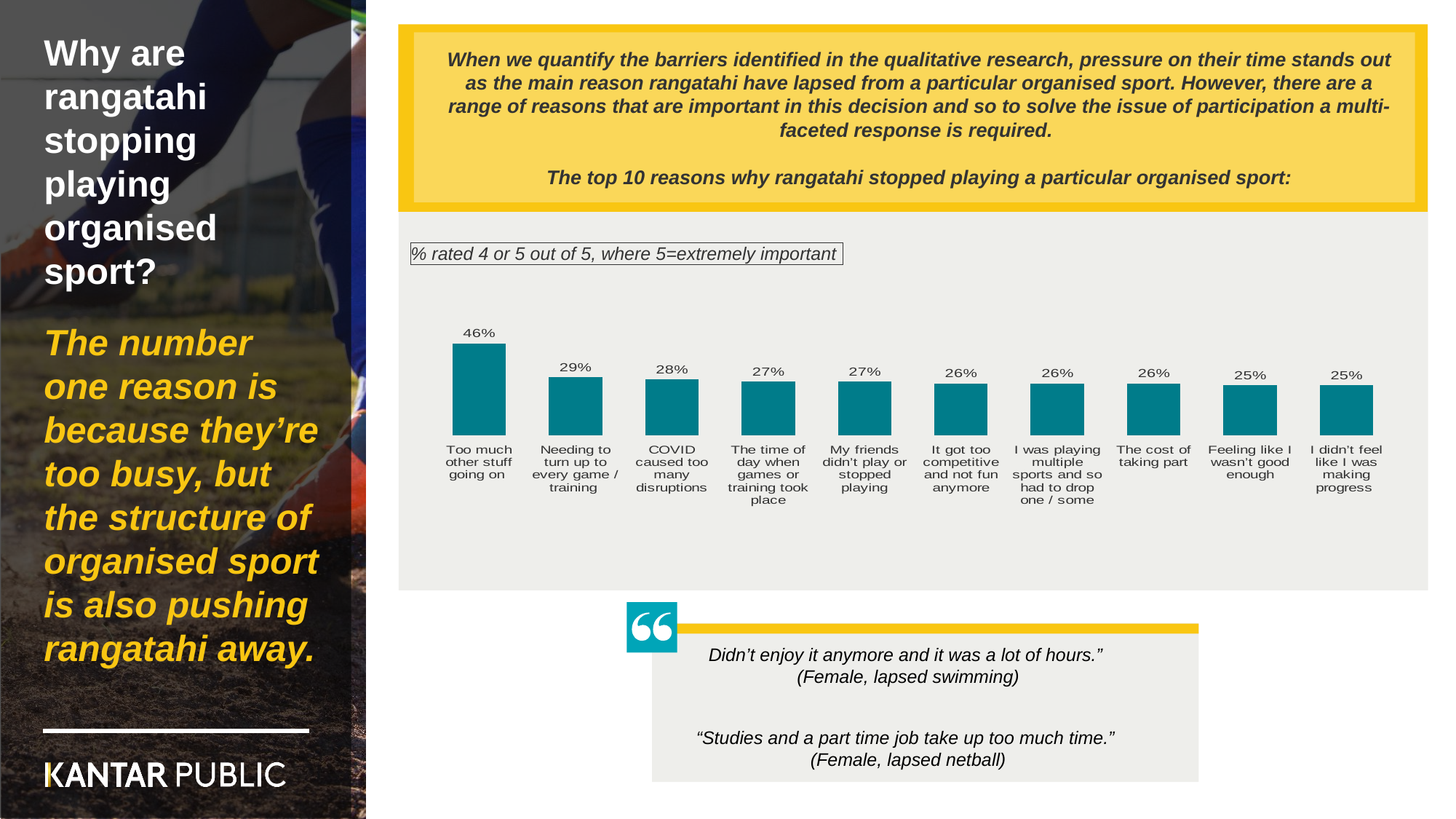
Do the values rise or fall moving from left to right across the chart? Fall What percentage of rangatahi rated "Too much other stuff going on" as an important reason for stopping? 46% What is the difference between "COVID caused too many disruptions" and "Feeling like I wasn't good enough"? 3 percentage points What is the value shown for "The cost of taking part"? 26% What does the note above the chart say the percentages represent? % rated 4 or 5 out of 5, where 5=extremely important What kind of chart is used to show the top 10 reasons? Bar chart How many reasons (bars) are shown in the chart? 10 What is the difference between "Too much other stuff going on" and "Needing to turn up to every game / training"? 17 percentage points Which is larger: the value for "Needing to turn up to every game / training" or the value for "I didn't feel like I was making progress"? Needing to turn up to every game / training What is the value shown for "My friends didn't play or stopped playing"? 27% What is the value shown for "COVID caused too many disruptions"? 28% Which reason has the highest percentage in the chart? Too much other stuff going on